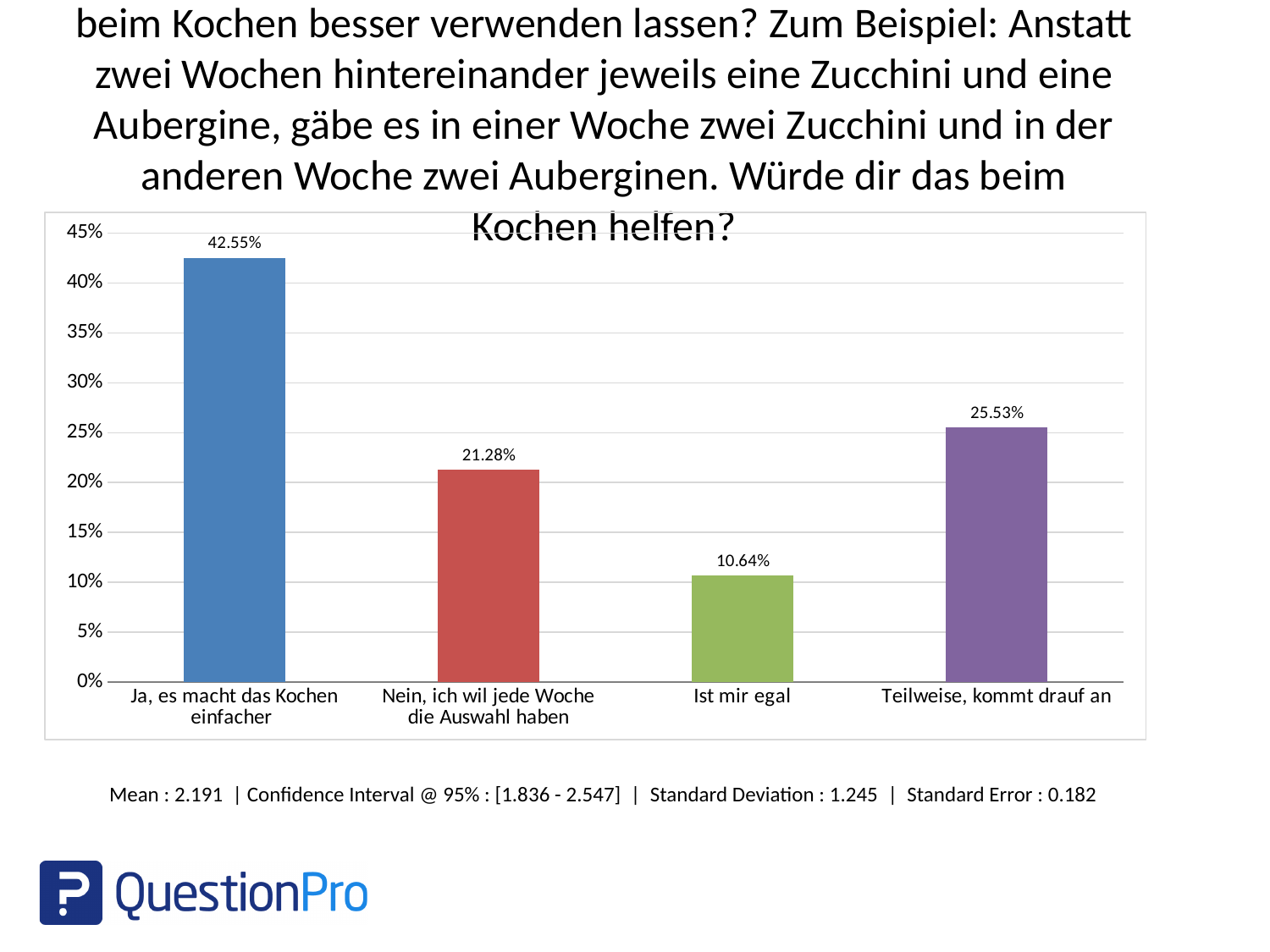
Which is larger: the value for "Nein, ich wil jede Woche die Auswahl haben" or for "Teilweise, kommt drauf an"? Teilweise, kommt drauf an How many categories are shown in the chart? 4 What kind of chart is shown on the slide? Bar chart What is the value for "Teilweise, kommt drauf an"? 25.53% What is the difference between the values for "Ja, es macht das Kochen einfacher" and "Teilweise, kommt drauf an"? 17.02% What colour is the bar for "Ist mir egal"? Green Is the value for "Ist mir egal" greater or less than 15%? less What is the value for "Ist mir egal"? 10.64% What is the value for "Ja, es macht das Kochen einfacher"? 42.55% What is the value for "Nein, ich wil jede Woche die Auswahl haben"? 21.28% Which category has the lowest value? Ist mir egal Which category has the highest value? Ja, es macht das Kochen einfacher